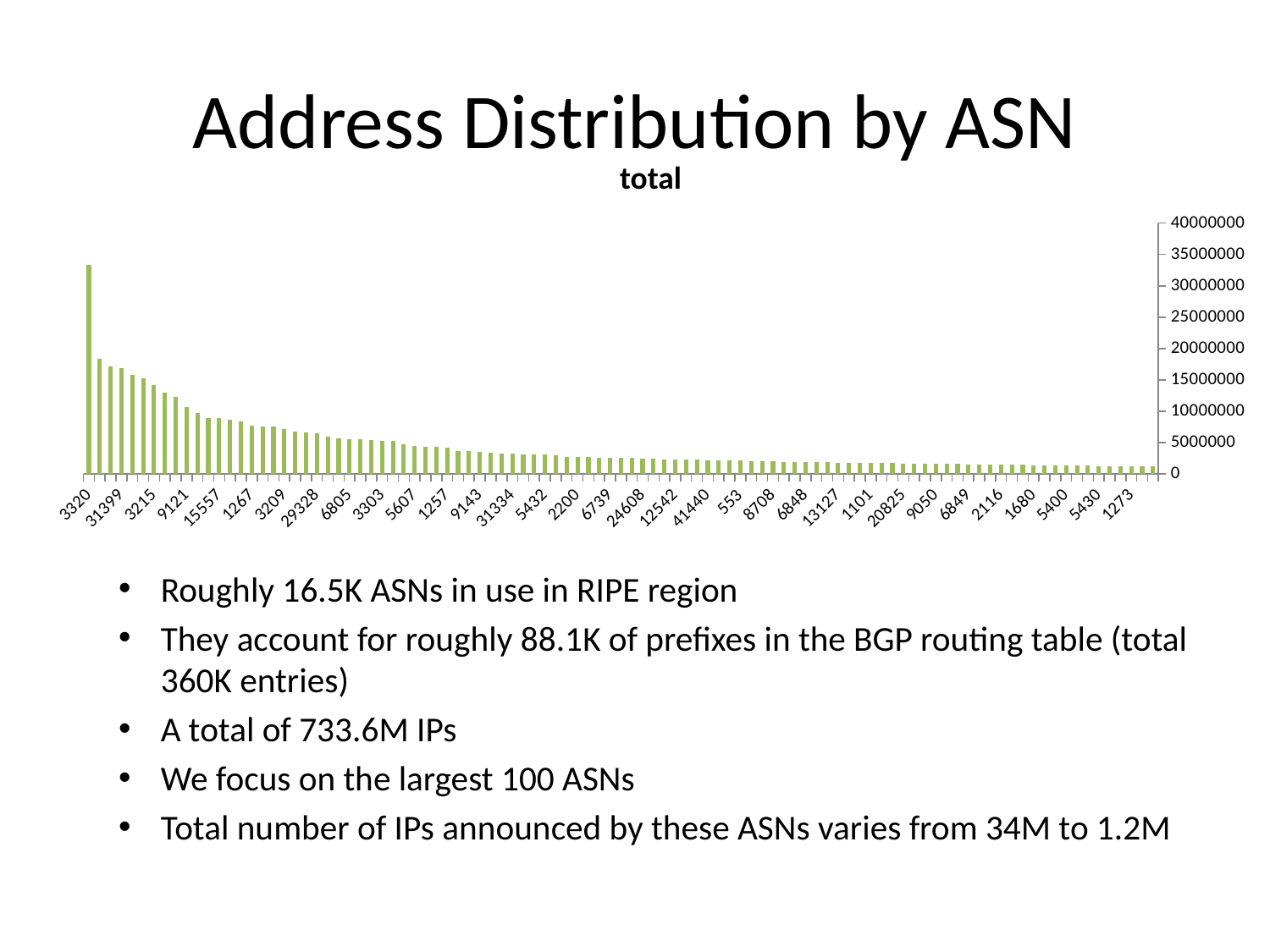
Which has the larger value, ASN 9121 or ASN 5400? 9121 Is the value for ASN 3320 greater or less than 30000000? greater Is the value for ASN 31399 greater or less than 10000000? greater Is the value for ASN 3320 greater or less than 35000000? less What kind of chart is shown on the slide? bar chart Do the values rise or fall from left to right along the x axis? fall How many ASNs are plotted in the chart? 99 Which has the larger value, ASN 3320 or ASN 31399? 3320 What is the title of the chart? total Which ASN has the highest value in the chart? 3320 What is the highest value shown on the y axis? 40000000